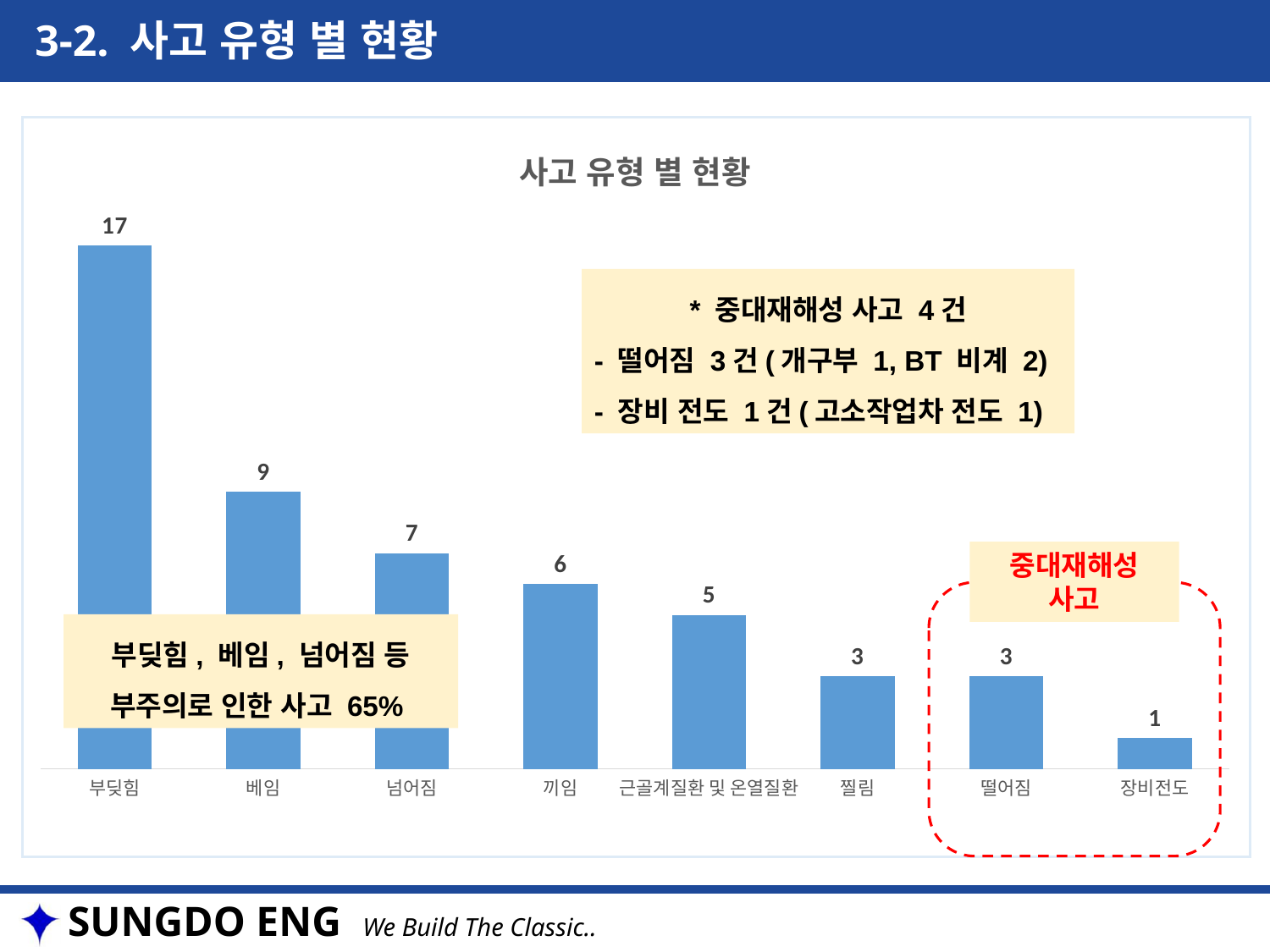
Which category has the lowest value? 장비전도 What is the title of the chart? 사고 유형 별 현황 What is the difference between the values for 부딪힘 and 베임? 8 What type of chart is shown on the slide? bar chart What is the value for 부딪힘? 17 What is the value for 베임? 9 Which is larger, the value for 넘어짐 or the value for 끼임? 넘어짐 What is the value for 근골계질환 및 온열질환? 5 How many categories are plotted in the chart? 8 What is the value for 장비전도? 1 Do the values rise or fall from left to right along the x axis? fall Which category has the highest value? 부딪힘